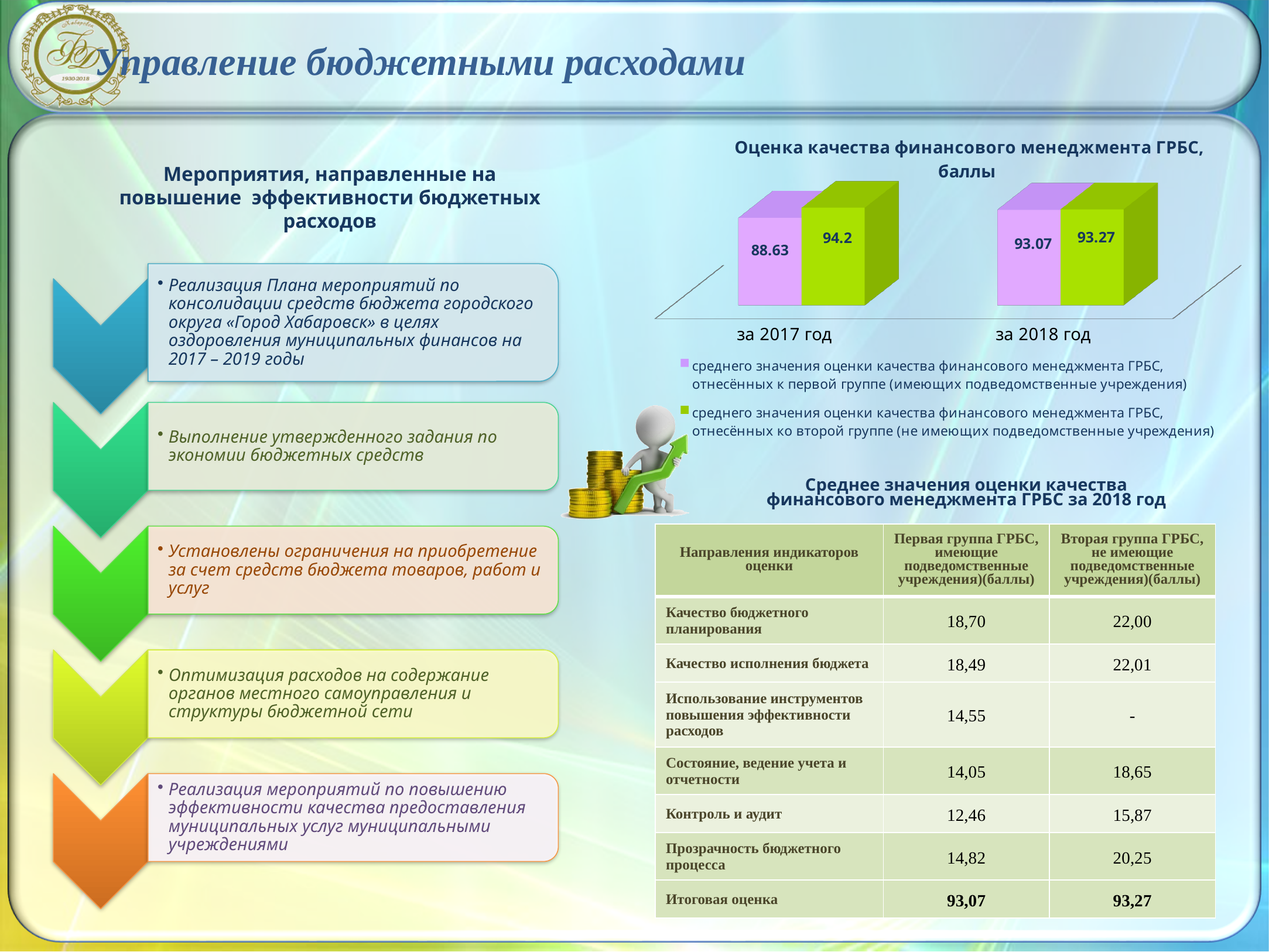
Which bar in the chart has the lowest value? First group, за 2017 год (88.63) Does the value for the first group of ГРБС rise or fall from 2017 to 2018? Rise What is the value for the first group of ГРБС (имеющих подведомственные учреждения) for 2017 in the chart 'Оценка качества финансового менеджмента ГРБС, баллы'? 88.63 What is the difference between the second group and the first group values for 2017? 5.57 Which bar in the chart has the highest value? Second group, за 2017 год (94.2) How many series does the legend of the chart list? 2 For 2017, which group has the larger value: the first group or the second group? Second group What is the value for the first group of ГРБС for 2018? 93.07 What is the value for the second group of ГРБС for 2018? 93.27 What is the difference between the second group and the first group values for 2018? 0.2 What kind of chart is 'Оценка качества финансового менеджмента ГРБС, баллы'? Bar chart What is the value for the second group of ГРБС (не имеющих подведомственные учреждения) for 2017? 94.2